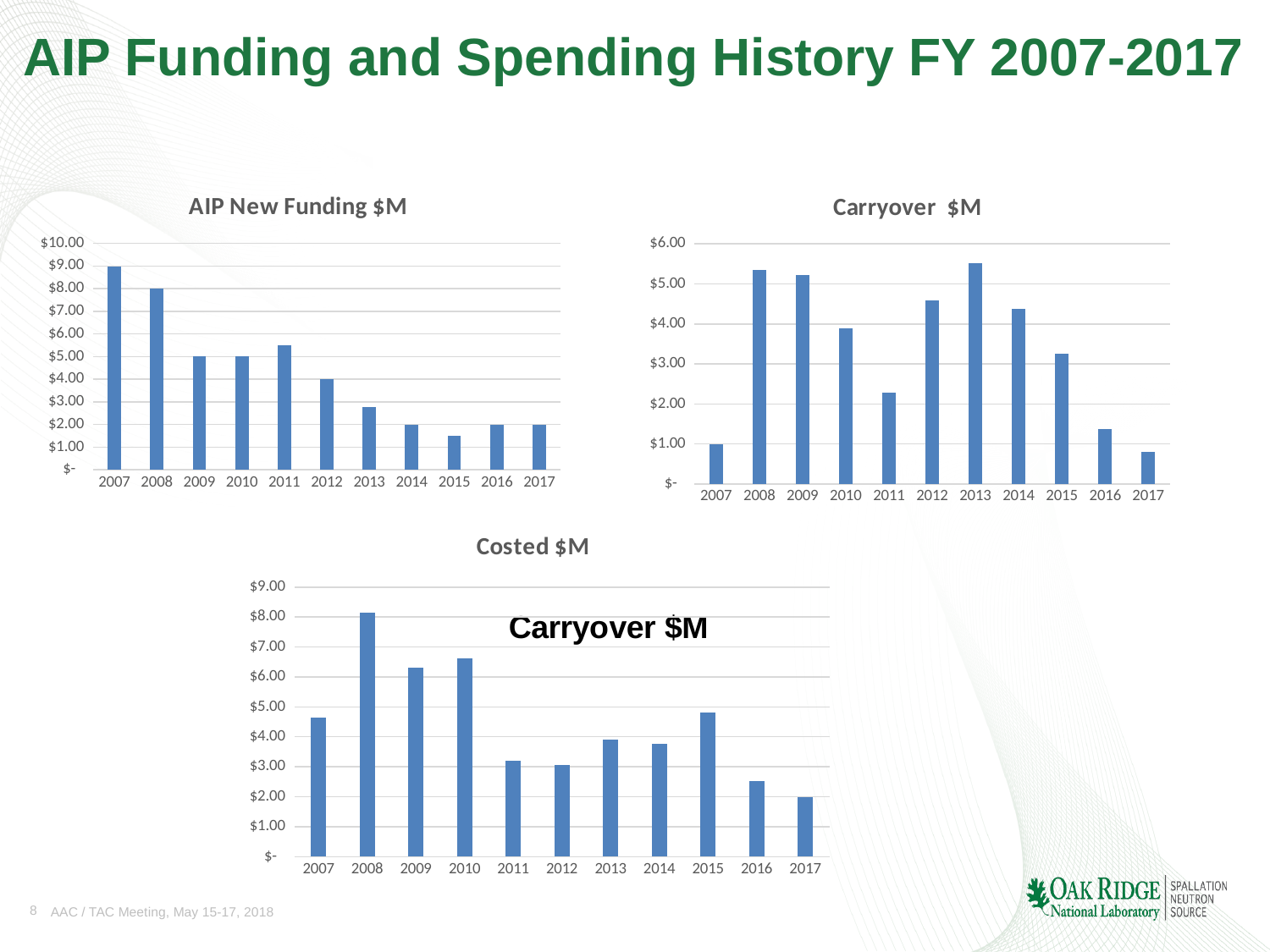
How many charts are shown on the slide? 3 In the 'Carryover $M' chart, which year has the lowest carryover? 2017 In the 'Costed $M' chart, which is larger, the value for 2012 or the value for 2013? 2013 In the 'AIP New Funding $M' chart, which year has the lowest new funding? 2015 In the 'Costed $M' chart, which year has the highest costed amount? 2008 In the 'AIP New Funding $M' chart, what is the value for 2008? $8.00 In the 'AIP New Funding $M' chart, which year has the highest new funding? 2007 In the 'Carryover $M' chart, is the value for 2011 greater or less than $3.00? less In the 'AIP New Funding $M' chart, how many fiscal years are shown on the x axis? 11 What kind of chart is the 'AIP New Funding $M' chart? bar chart In the 'AIP New Funding $M' chart, do the values generally rise or fall from 2007 to 2017? fall In the 'Carryover $M' chart, which year has the highest carryover? 2013